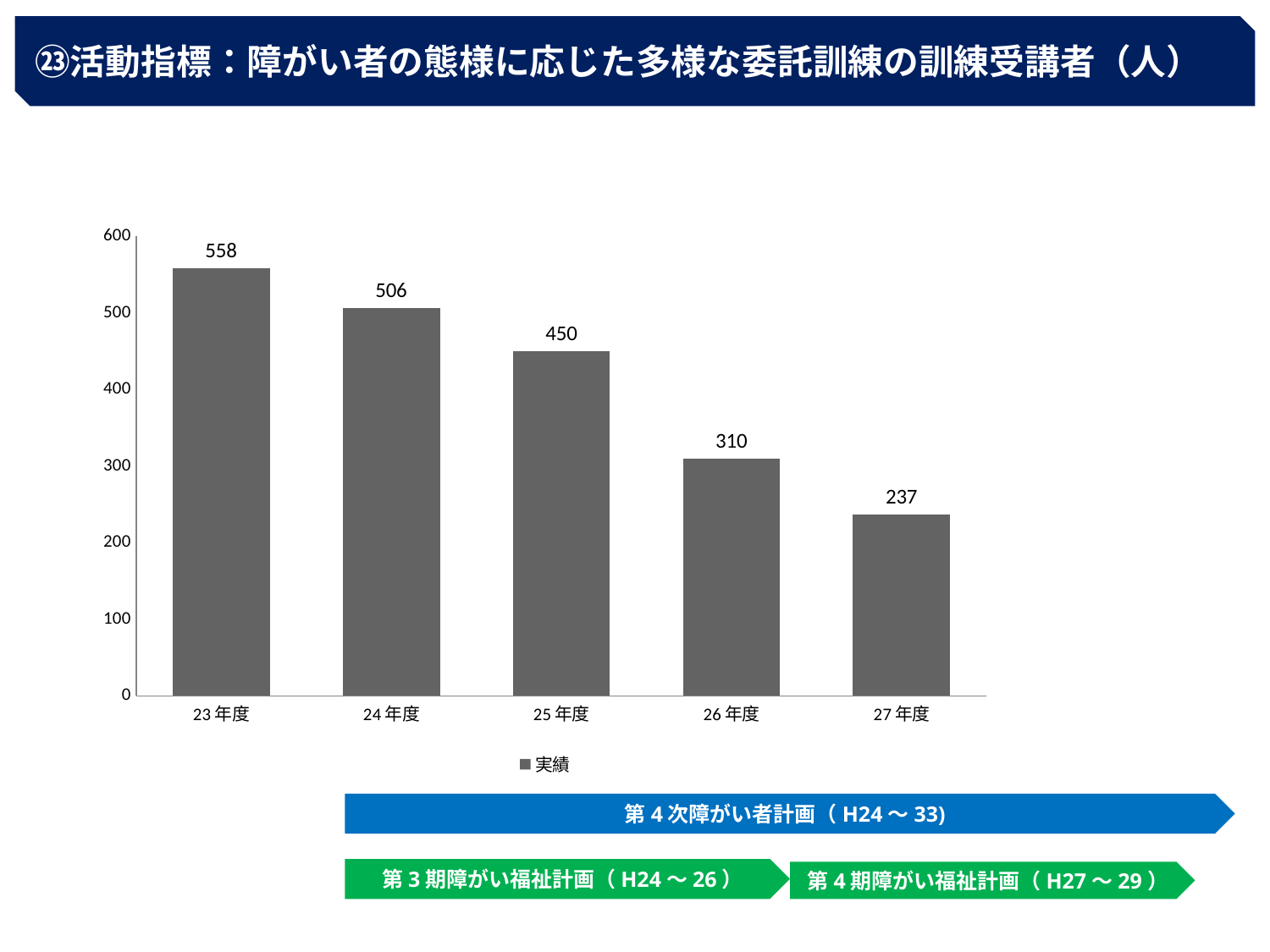
What kind of chart is shown on the slide? bar chart What is the difference between the values for 26年度 and 27年度? 73 How many years are shown on the x axis? 5 Which is larger, the value for 25年度 or the value for 26年度? 25年度 Which year has the lowest value? 27年度 What is the value for 25年度? 450 Do the values rise or fall from 23年度 to 27年度? fall Is the value for 26年度 greater or less than 400? less Which year has the highest value? 23年度 What is the value for 27年度? 237 What is the difference between the values for 23年度 and 24年度? 52 What is the value for 23年度? 558